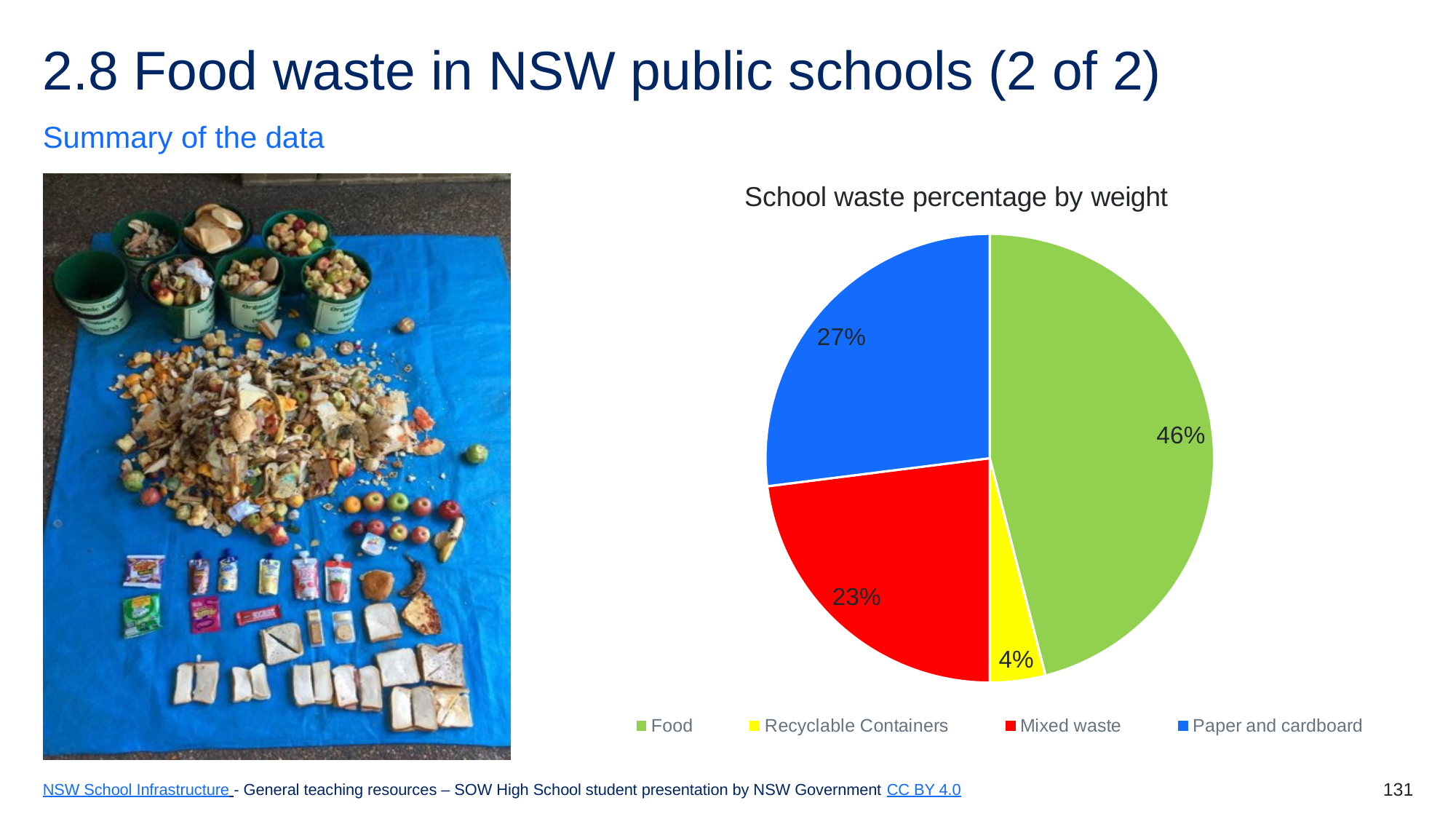
What type of chart is shown on the slide? pie chart Which is larger: the share for Mixed waste or the share for Paper and cardboard? Paper and cardboard What percentage of school waste by weight is Paper and cardboard? 27% What percentage of school waste by weight is Recyclable Containers? 4% What is the title of the chart? School waste percentage by weight What is the difference in percentage points between Food and Paper and cardboard? 19 What colour is the slice for Mixed waste? red How many categories does the pie chart show? 4 What percentage of school waste by weight is Food? 46% Which category makes up the smallest share of school waste by weight? Recyclable Containers What percentage of school waste by weight is Mixed waste? 23% Which category makes up the largest share of school waste by weight? Food